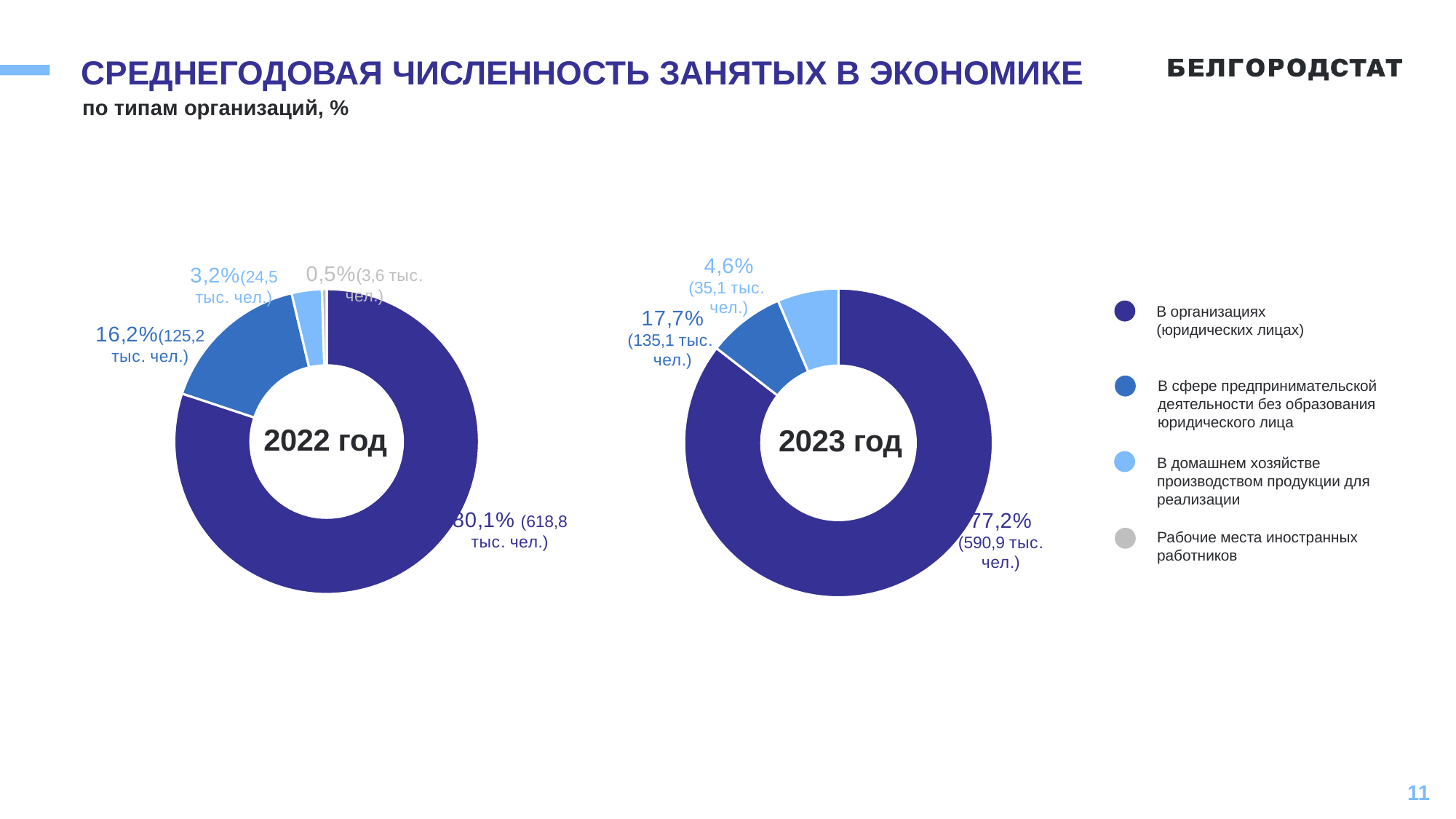
What is the difference in percentage points between the share of 'В организациях (юридических лицах)' in 2022 год and in 2023 год? 2,9 In the 2023 год chart, how many thousand people are shown for 'В организациях (юридических лицах)'? 590,9 тыс. чел. What type of chart is used on the slide for 2022 год and 2023 год? Pie (donut) chart In the 2023 год chart, what share is shown for 'В организациях (юридических лицах)'? 77,2% In the 2022 год chart, what share is shown for 'В организациях (юридических лицах)'? 80,1% In the 2022 год chart, how many thousand people are shown for 'В сфере предпринимательской деятельности без образования юридического лица'? 125,2 тыс. чел. In the 2023 год chart, which category has the largest share? В организациях (юридических лицах) In the 2022 год chart, which category has the smallest share? Рабочие места иностранных работников In the 2023 год chart, what share is shown for 'В домашнем хозяйстве производством продукции для реализации'? 4,6% How many categories does the legend list? 4 Which is larger: the share of 'В сфере предпринимательской деятельности без образования юридического лица' in 2022 год or in 2023 год? 2023 год In the 2022 год chart, what share is shown for 'Рабочие места иностранных работников'? 0,5%